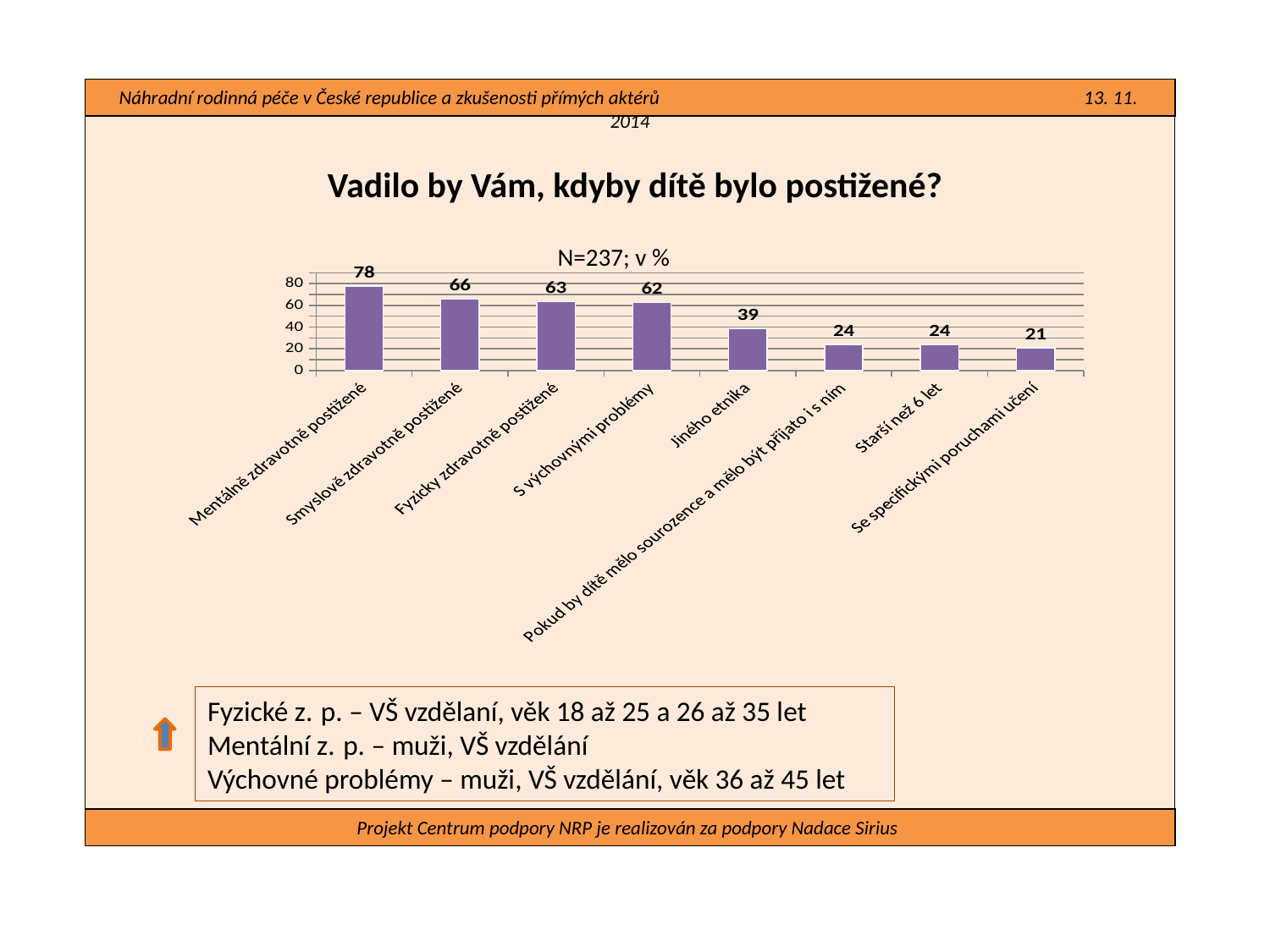
Do the values rise or fall from left to right along the x axis? Fall Which category has the lowest value? Se specifickými poruchami učení Which is larger, the value for "Fyzicky zdravotně postižené" or the value for "Jiného etnika"? Fyzicky zdravotně postižené What is the value for "Se specifickými poruchami učení"? 21 Which category has the highest value? Mentálně zdravotně postižené How many categories are shown in the chart? 8 What is the value for "S výchovnými problémy"? 62 What is the value for "Mentálně zdravotně postižené"? 78 What is the value for "Jiného etnika"? 39 What kind of chart is shown on the slide? Bar chart What is the chart's title? N=237; v % What is the difference between the values for "Mentálně zdravotně postižené" and "Smyslově zdravotně postižené"? 12